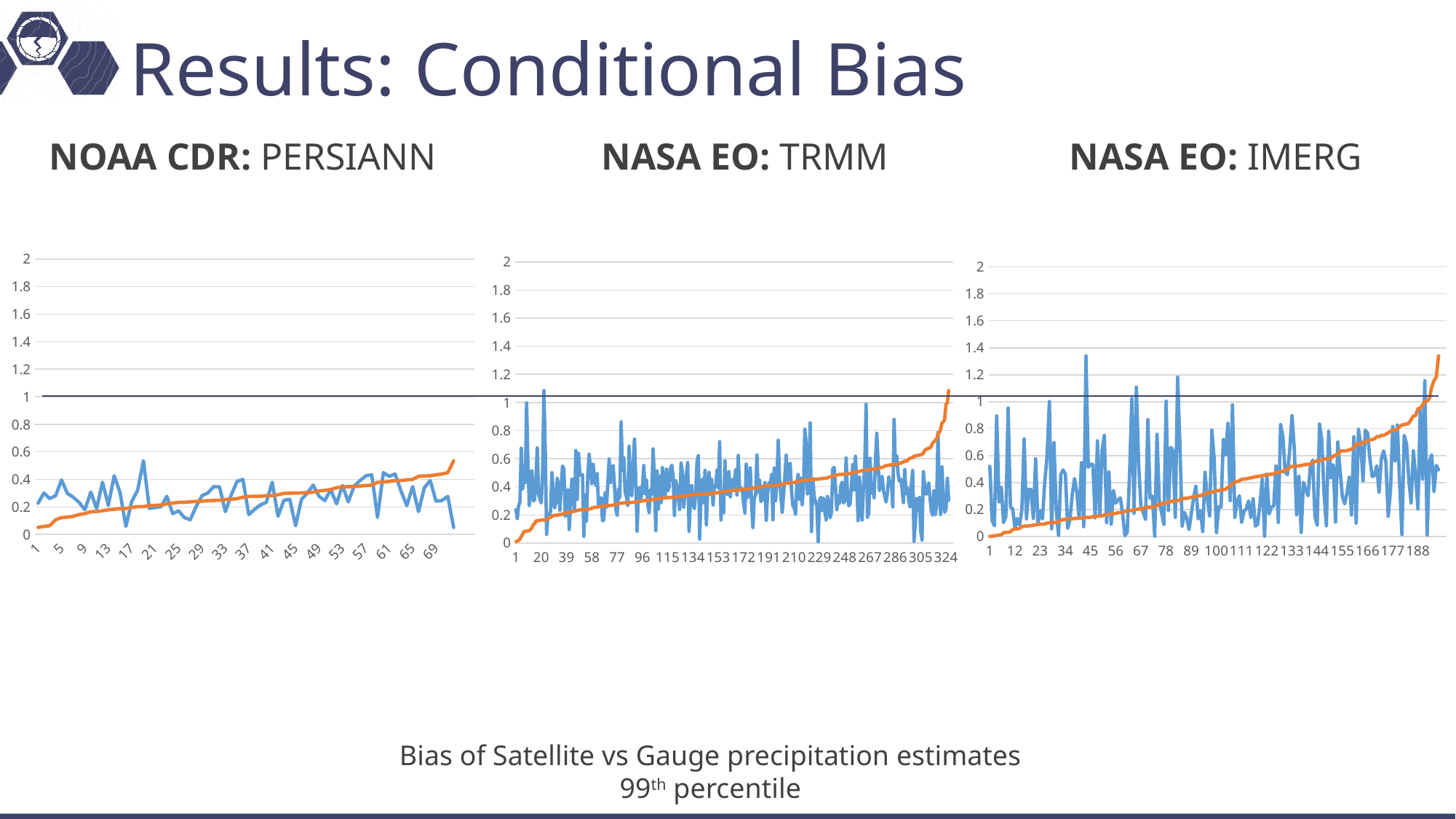
In the NASA EO: TRMM chart, does the orange line rise or fall along the x axis? rise What kind of chart is the NOAA CDR: PERSIANN chart? line chart In the NOAA CDR: PERSIANN chart, is the highest point of the blue line greater or less than 0.8? less What is the last x-axis label on the NASA EO: TRMM chart? 324 In the NOAA CDR: PERSIANN chart, is the final value of the orange line greater or less than 1? less In the NASA EO: IMERG chart, is the final value of the orange line greater or less than 1? greater What is the maximum value shown on the y axis of the NASA EO: TRMM chart? 2 Which of the three charts has the orange line reaching the highest value at its right end? NASA EO: IMERG How many lines are plotted in the NASA EO: IMERG chart? 2 In the NASA EO: IMERG chart, does the orange line rise or fall from left to right? rise How many charts are shown on the slide? 3